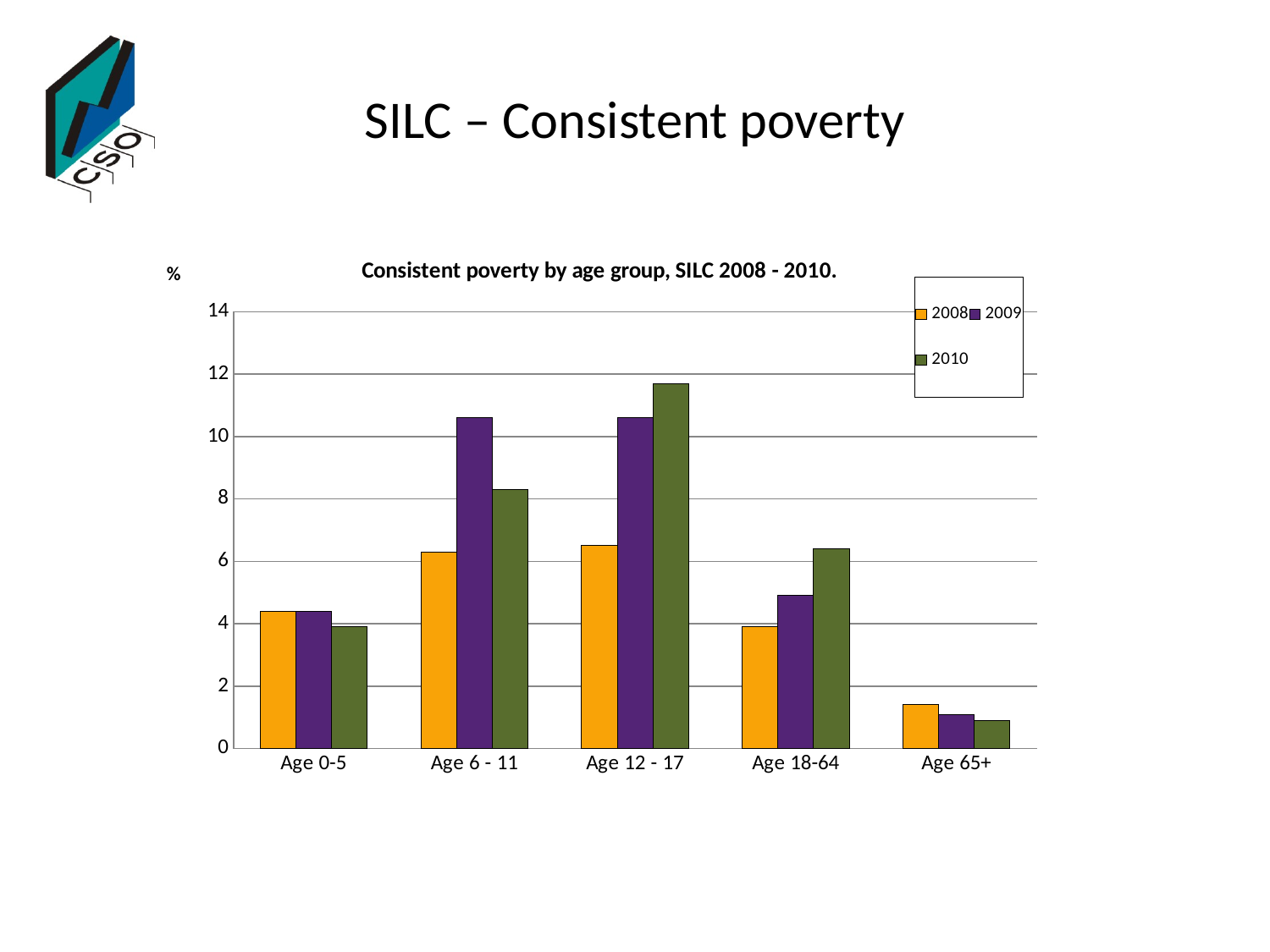
How many age groups are shown on the x axis? 5 Which age group has the lowest value for 2009? Age 65+ How many series does the legend list? 3 Which age group has the highest value for 2010? Age 12 - 17 Which age group has the lowest value for 2010? Age 65+ Is the value for Age 18-64 in 2009 greater or less than 6? less What kind of chart is shown on the slide? bar chart What is the title of the chart? Consistent poverty by age group, SILC 2008 - 2010. For Age 18-64, do the values rise or fall from 2008 to 2010? rise Is the value for Age 12 - 17 in 2010 greater or less than 10? greater For Age 6 - 11, which year has the larger value, 2008 or 2009? 2009 Is the value for Age 65+ in 2010 greater or less than 2? less